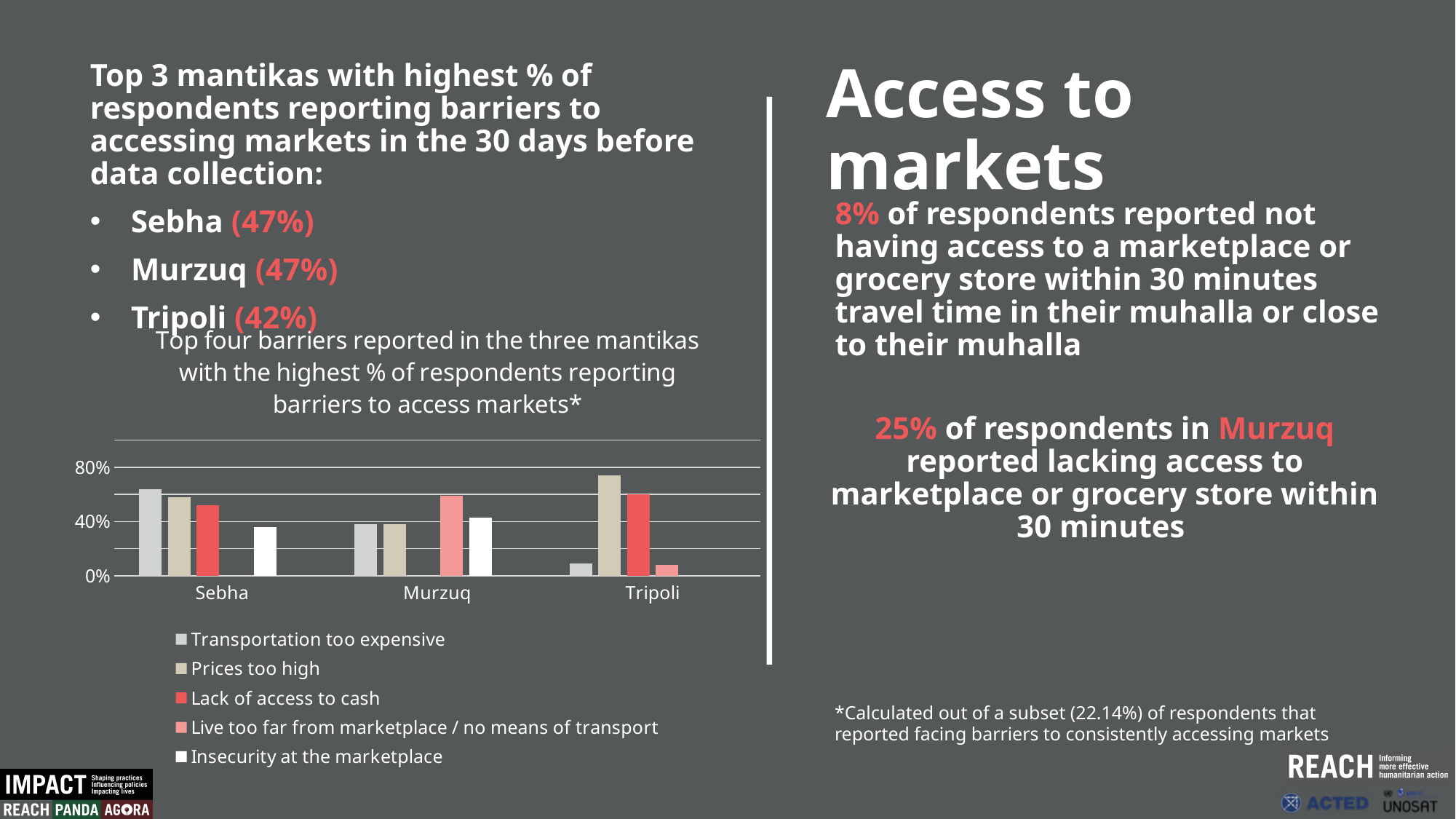
How many mantikas (categories) are shown on the x axis of the chart? 3 Is the value for 'Prices too high' in Tripoli greater or less than 40%? greater How many series does the chart's legend list? 5 Which barrier has the highest value in Tripoli? Prices too high Is the value for 'Live too far from marketplace / no means of transport' in Tripoli greater or less than 40%? less Is the value for 'Live too far from marketplace / no means of transport' in Murzuq greater or less than 40%? greater In Tripoli, which is larger: 'Prices too high' or 'Transportation too expensive'? Prices too high What kind of chart is shown on the slide? Bar chart Which barrier has the highest value in Murzuq? Live too far from marketplace / no means of transport Which legend entry is shown in red in the chart? Lack of access to cash